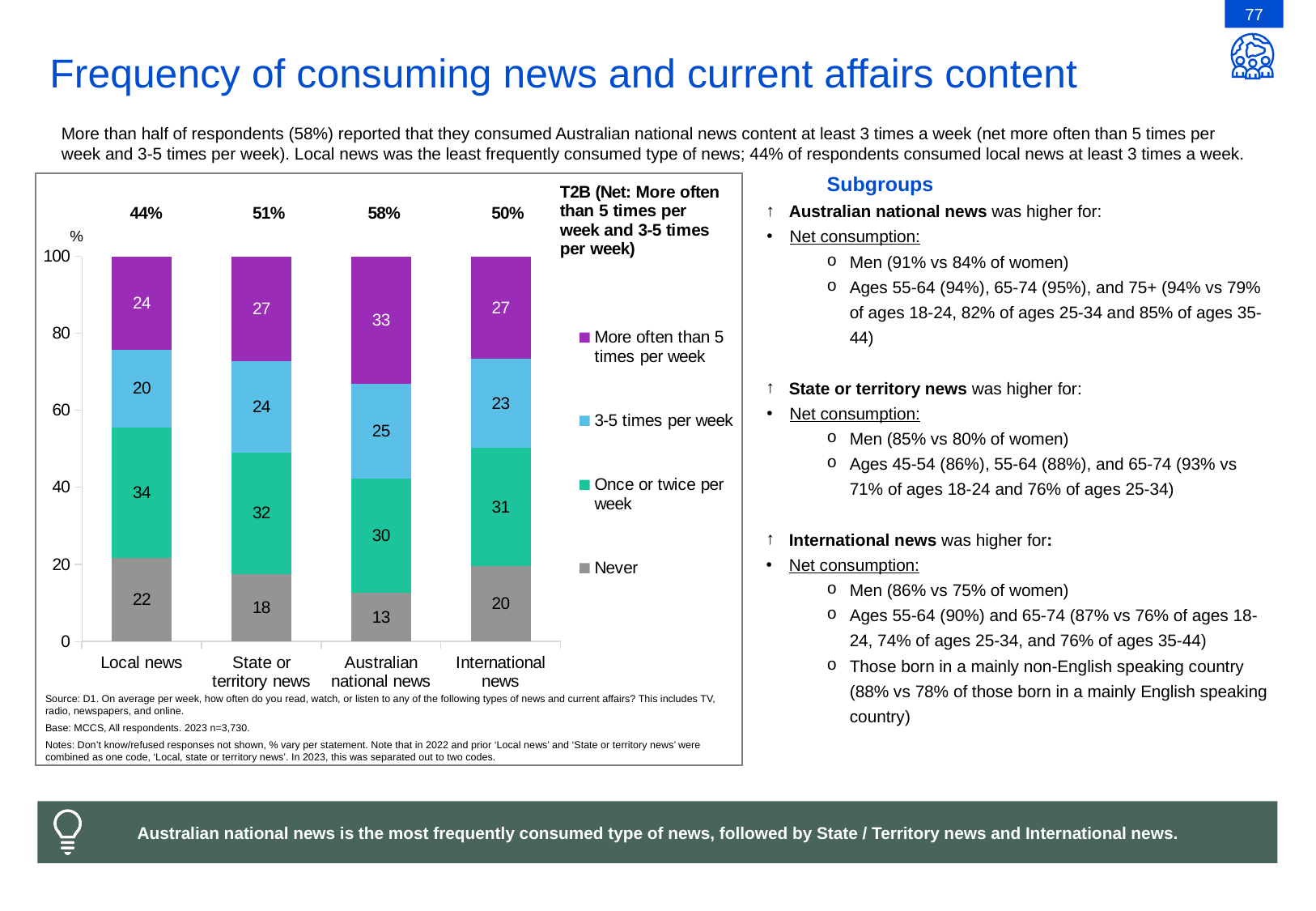
What is the 'Never' value for Australian national news? 13 What is the '3-5 times per week' value for State or territory news? 24 Which is larger: the 'Never' value for Local news or for International news? Local news What kind of chart is shown on the slide? Stacked bar chart How many series does the chart legend list? 4 How many news categories are shown on the x axis of the chart? 4 What is the difference between the 'Once or twice per week' values for Local news and Australian national news? 4 Which news category has the highest 'More often than 5 times per week' value? Australian national news Which legend entry is shown in purple? More often than 5 times per week What is the 'More often than 5 times per week' value for Local news? 24 What is the T2B (net) percentage shown above the International news bar? 50% Which news category has the lowest T2B (net) percentage? Local news